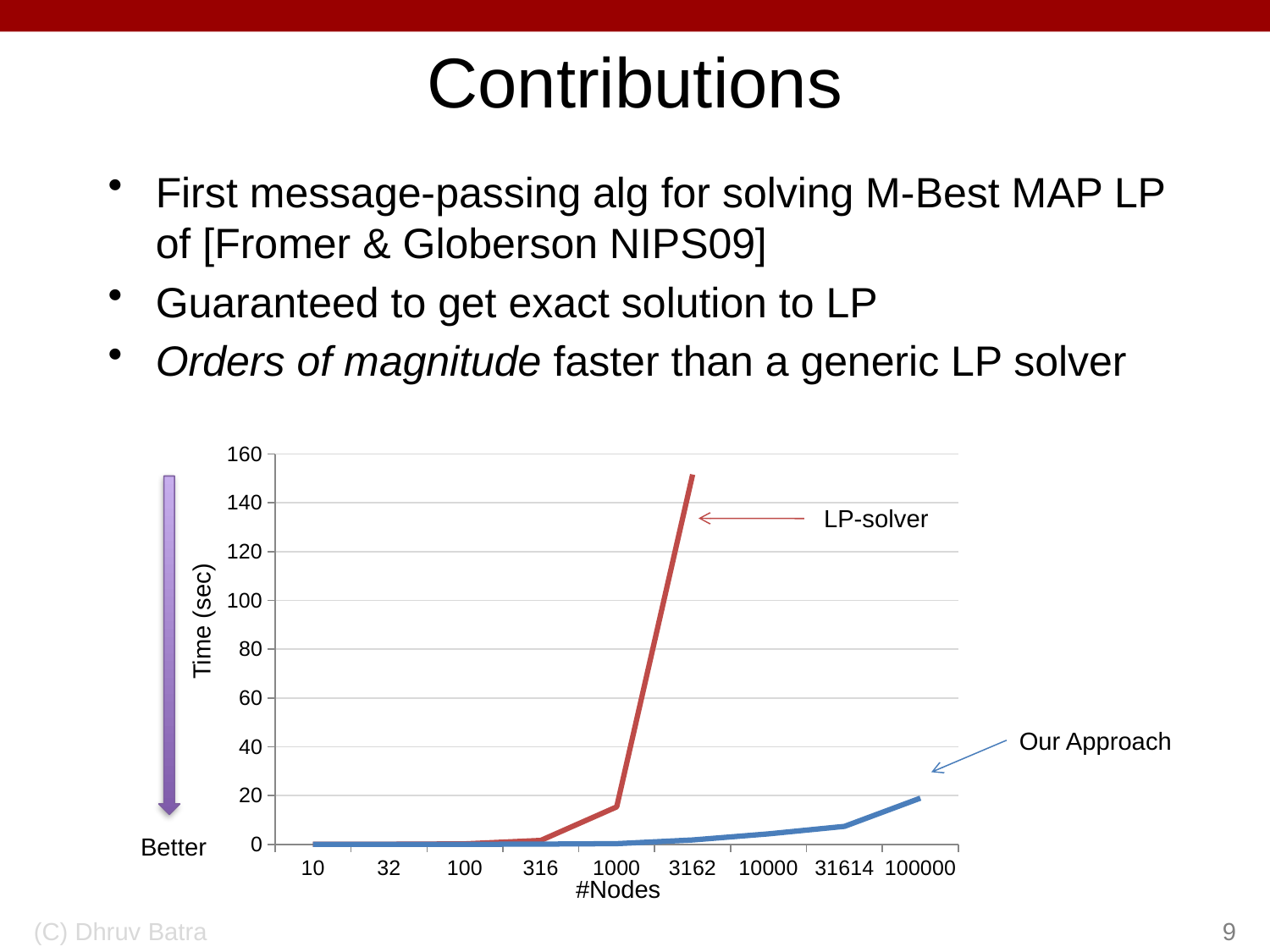
How many #Nodes values are marked on the x axis of the chart? 9 Is the Our Approach time at 100000 nodes greater or less than 40 seconds? less What colour is the line for Our Approach? blue Does the Our Approach time rise or fall as the number of nodes increases? rise What kind of chart is shown on the slide? line chart Is the LP-solver time at 1000 nodes greater or less than 40 seconds? less Does the LP-solver time rise or fall as the number of nodes increases? rise Is the Our Approach time at 31614 nodes greater or less than 20 seconds? less How many data series are plotted in the chart? 2 At 3162 nodes, which series has the higher time: LP-solver or Our Approach? LP-solver What is the label of the y axis of the chart? Time (sec)